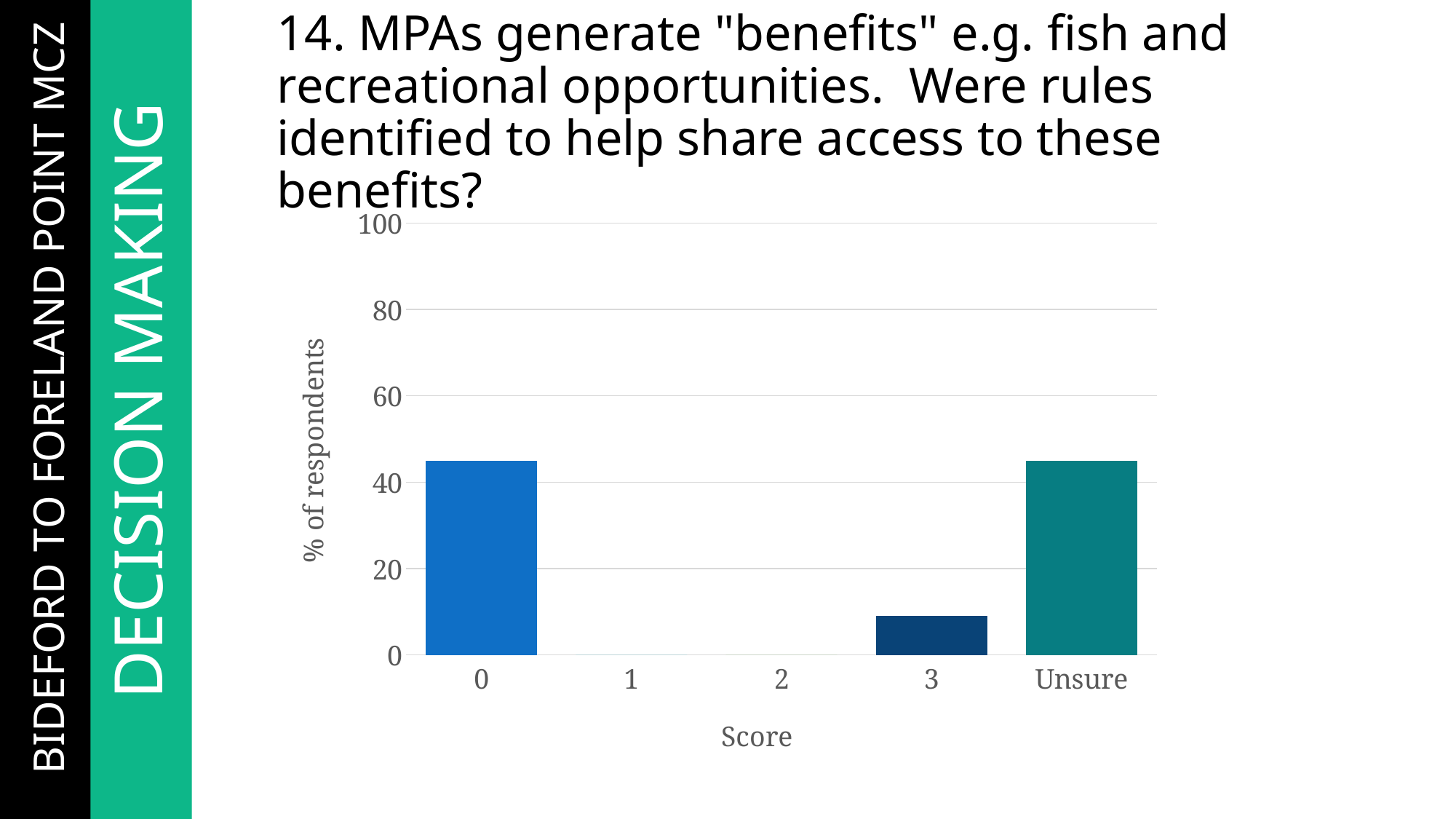
How many score categories are shown on the x axis of the chart? 5 Is the value for score 0 greater or less than 40? greater Is the value for Unsure greater or less than 60? less What kind of chart is shown on the slide? bar chart Which score categories have no visible bar in the chart? 1 and 2 Is the value for score 3 greater or less than 20? less Which has the larger value, Unsure or score 3? Unsure What is the label of the y axis of the chart? % of respondents Which has the larger value, score 0 or score 3? 0